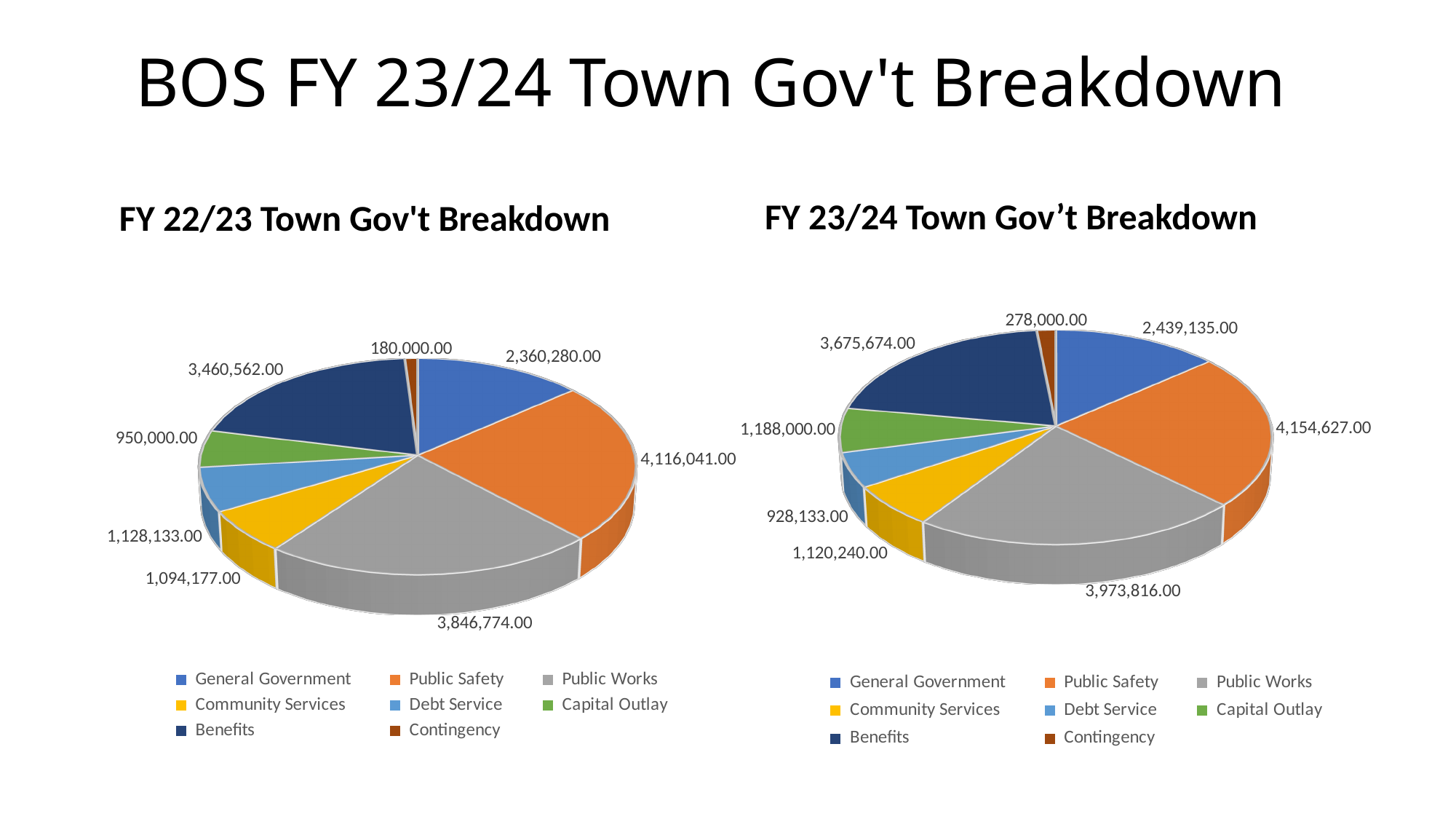
In the FY 23/24 Town Gov't Breakdown chart, which category has the smallest value? Contingency In the FY 23/24 Town Gov't Breakdown chart, what is the value for Debt Service? 928,133.00 What is the difference between the Contingency value in the FY 23/24 chart and the Contingency value in the FY 22/23 chart? 98,000.00 In the FY 23/24 Town Gov't Breakdown chart, which colour represents Public Works? Grey Which is larger: Public Works in the FY 22/23 chart or Public Works in the FY 23/24 chart? FY 23/24 (3,973,816.00) In the FY 22/23 Town Gov't Breakdown chart, what is the value for Public Safety? 4,116,041.00 In the FY 22/23 Town Gov't Breakdown chart, which category has the largest value? Public Safety In the FY 22/23 Town Gov't Breakdown chart, what is the difference between Public Safety and Public Works? 269,267.00 In the FY 22/23 Town Gov't Breakdown chart, what is the value for Capital Outlay? 950,000.00 How many categories does the FY 23/24 Town Gov't Breakdown chart show? 8 In the FY 23/24 Town Gov't Breakdown chart, what is the value for Benefits? 3,675,674.00 What type of chart is the FY 22/23 Town Gov't Breakdown chart? Pie chart